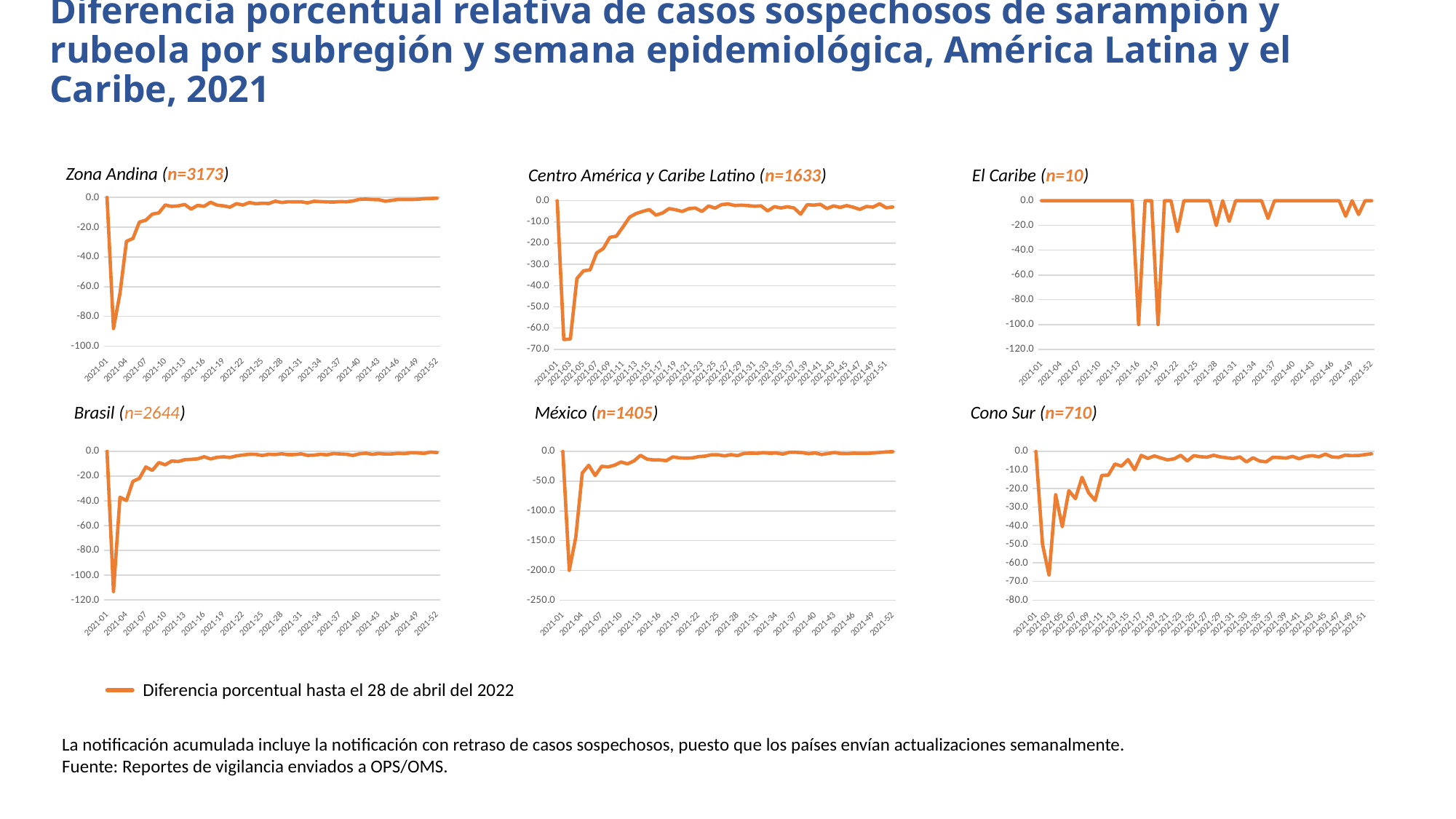
In the Zona Andina chart, do the values generally rise or fall along the x axis after the initial dip? rise What kind of chart is used for the Zona Andina panel? line chart In the El Caribe chart, is the lowest value greater or less than -80.0? less In the Cono Sur chart, is the lowest value greater or less than -60.0? less How many series does the legend list? 1 In the Brasil chart, is the lowest value greater or less than -100.0? less What is the legend entry for the plotted series? Diferencia porcentual hasta el 28 de abril del 2022 How many charts are shown on the slide? 6 What is the n value shown in the title of the Brasil chart? n=2644